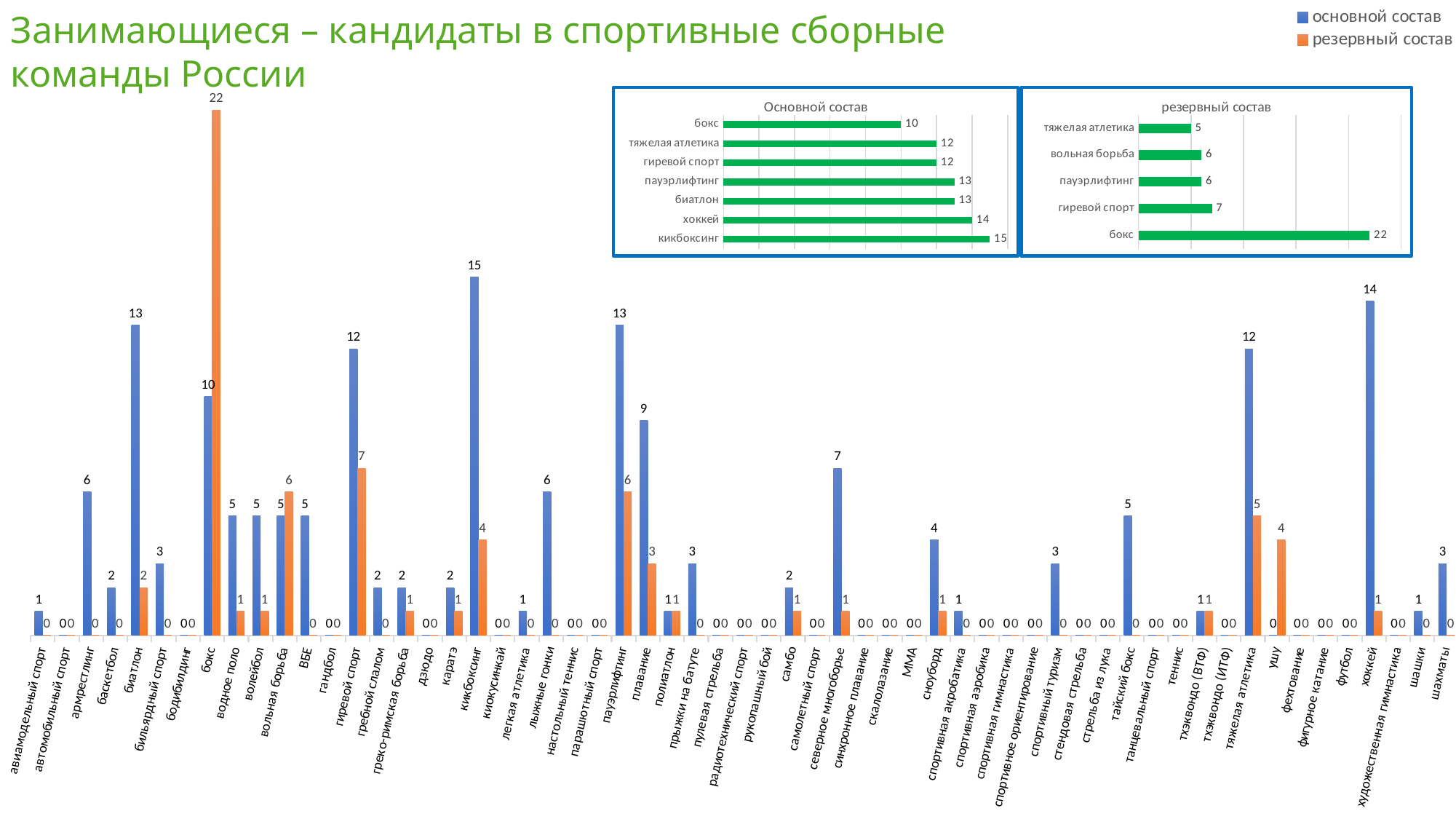
How many categories are shown in the inset chart titled 'Основной состав'? 7 On the large bar chart, what is the difference between the основной состав and резервный состав values for кикбоксинг? 11 On the large bar chart, which category has the highest value in the резервный состав series? бокс In the inset chart titled 'резервный состав', which category has the lowest value? тяжелая атлетика In the inset chart titled 'резервный состав', what is the value for гиревой спорт? 7 On the large bar chart, which category has the highest value in the основной состав series? кикбоксинг How many series does the legend of the large bar chart list? 2 What kind of chart is the inset chart titled 'Основной состав'? bar chart On the large bar chart, what colour represents the резервный состав series? orange On the large bar chart, what is the difference between the основной состав and резервный состав values for гиревой спорт? 5 On the large bar chart, what is the value for бокс in the резервный состав series? 22 On the large bar chart, which is larger in the основной состав series: хоккей or плавание? хоккей